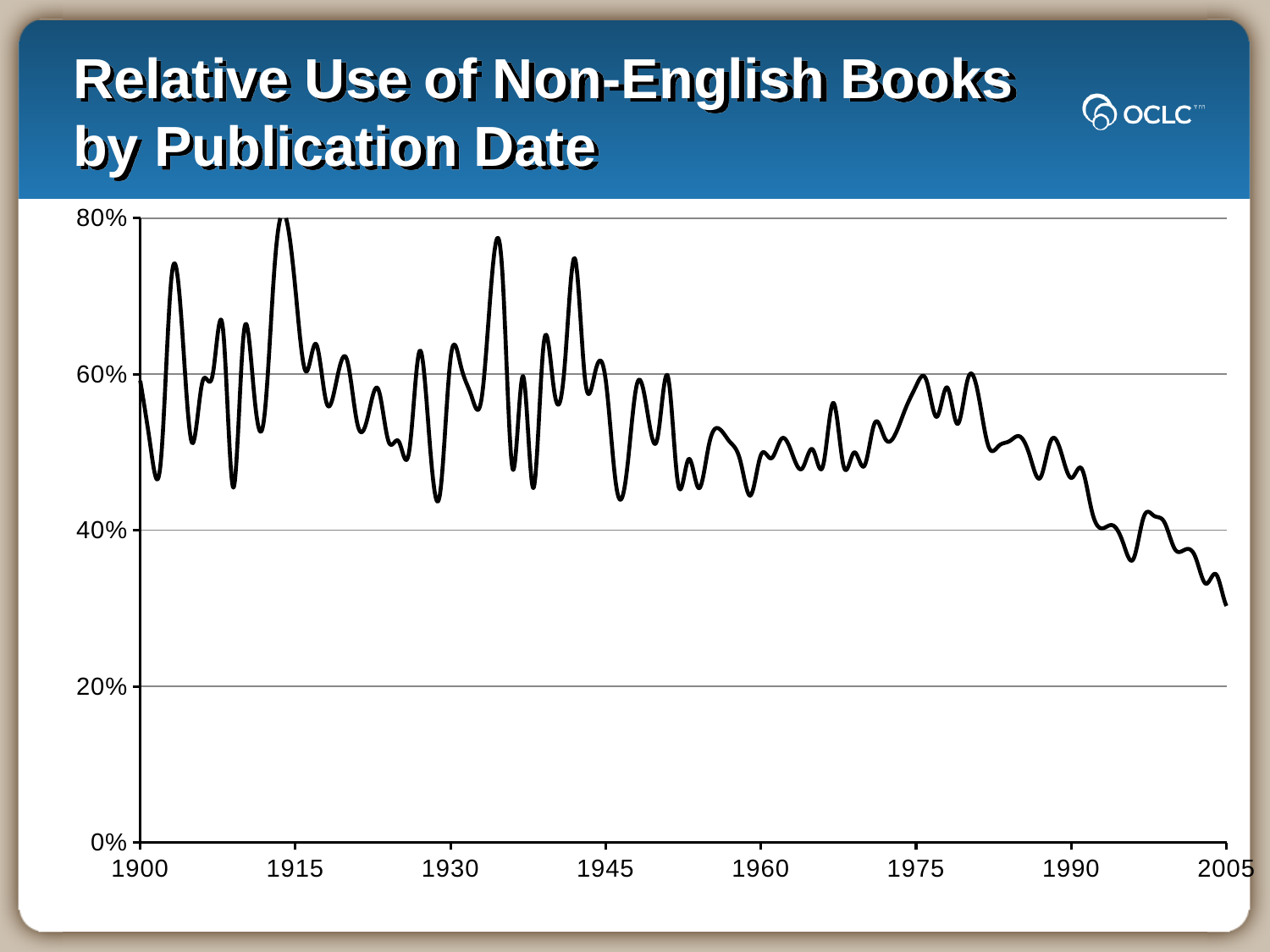
What kind of chart is shown on the slide? line chart How many lines are plotted on the chart? 1 Is the value for 1960 greater or less than 60%? less Is the value for 1900 greater or less than 40%? greater What is the highest value labelled on the y axis? 80% Is the value for 1975 greater or less than 40%? greater How many year labels are shown on the x axis? 8 What is the title of the chart on the slide? Relative Use of Non-English Books by Publication Date Between 1975 and 2005, does the line generally rise or fall? fall Overall, does the relative use of non-English books rise or fall from 1900 to 2005? fall